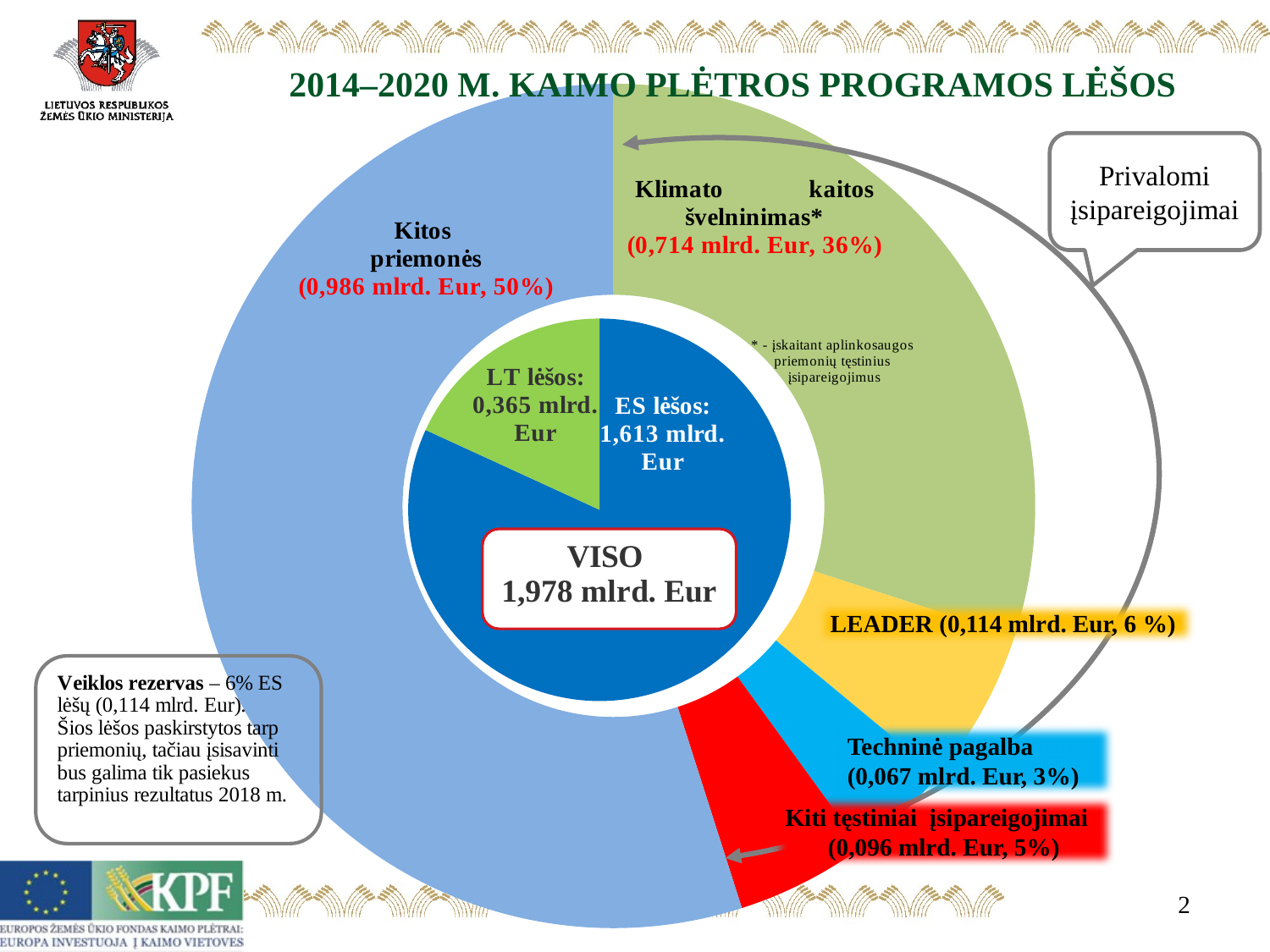
What is the value for LEADER? 0,114 mlrd. Eur What is the value for ES lėšos in the inner pie? 1,613 mlrd. Eur What is the value for Kitos priemonės in the outer ring? 0,986 mlrd. Eur Which category in the outer ring has the largest share? Kitos priemonės Which is larger in the inner pie, ES lėšos or LT lėšos? ES lėšos How many categories are shown in the outer ring? 5 What is the value for Techninė pagalba? 0,067 mlrd. Eur What is the total (VISO) shown in the centre of the chart? 1,978 mlrd. Eur Which category in the outer ring has the smallest share? Techninė pagalba What share of the outer ring does Klimato kaitos švelninimas represent? 36% What share of the outer ring does Kiti tęstiniai įsipareigojimai represent? 5% What kind of chart is shown on the slide? pie chart